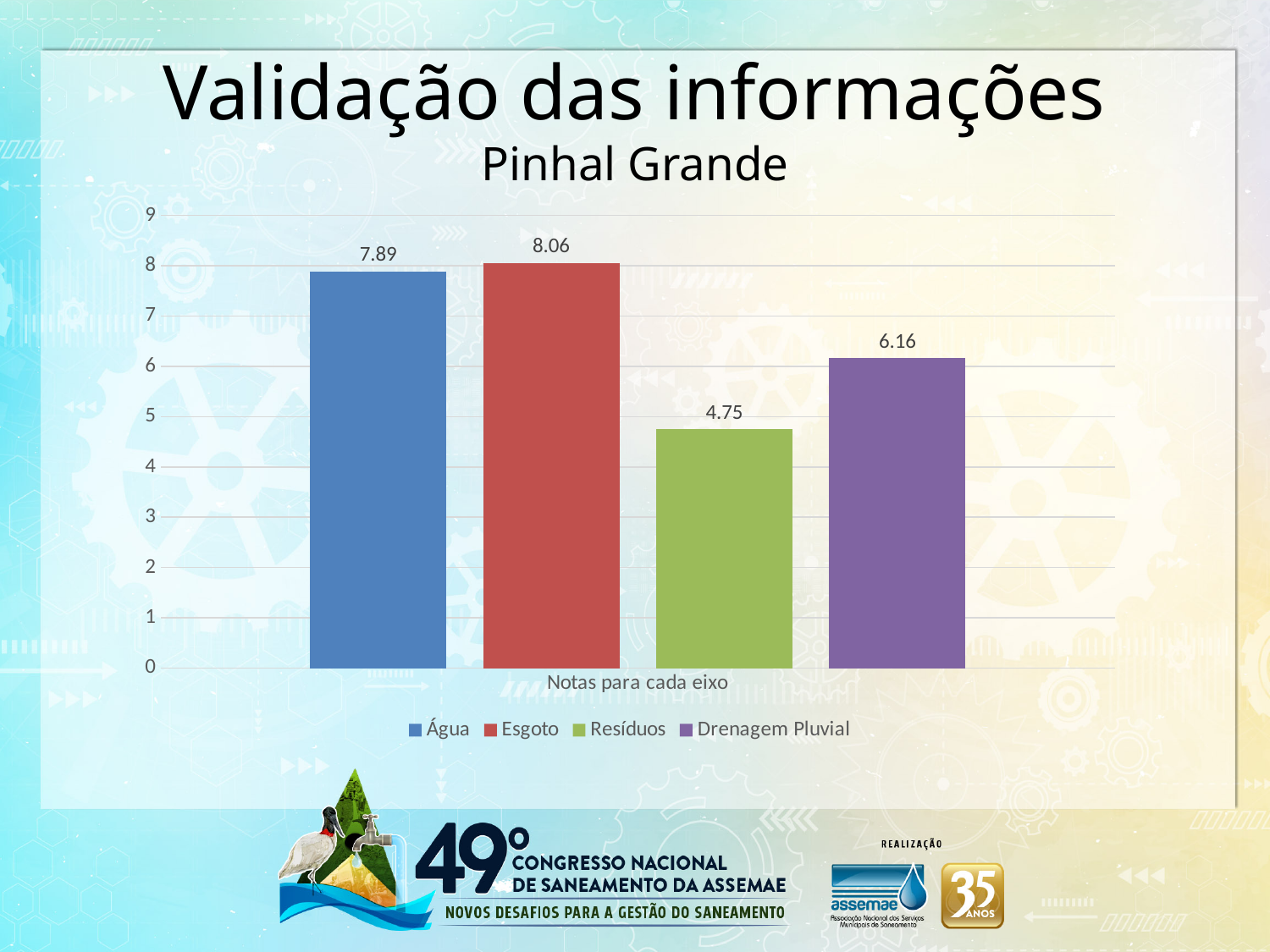
Which category has the highest value? Esgoto Which is larger, the value for Drenagem Pluvial or the value for Resíduos? Drenagem Pluvial What is the value for Água? 7.89 What is the value for Drenagem Pluvial? 6.16 What is the difference between the values for Água and Drenagem Pluvial? 1.73 How many bars are plotted in the chart? 4 How many entries does the legend list? 4 What is the value for Esgoto? 8.06 What is the value for Resíduos? 4.75 What kind of chart is shown on the slide? Bar chart Which category has the lowest value? Resíduos What is the difference between the values for Esgoto and Resíduos? 3.31